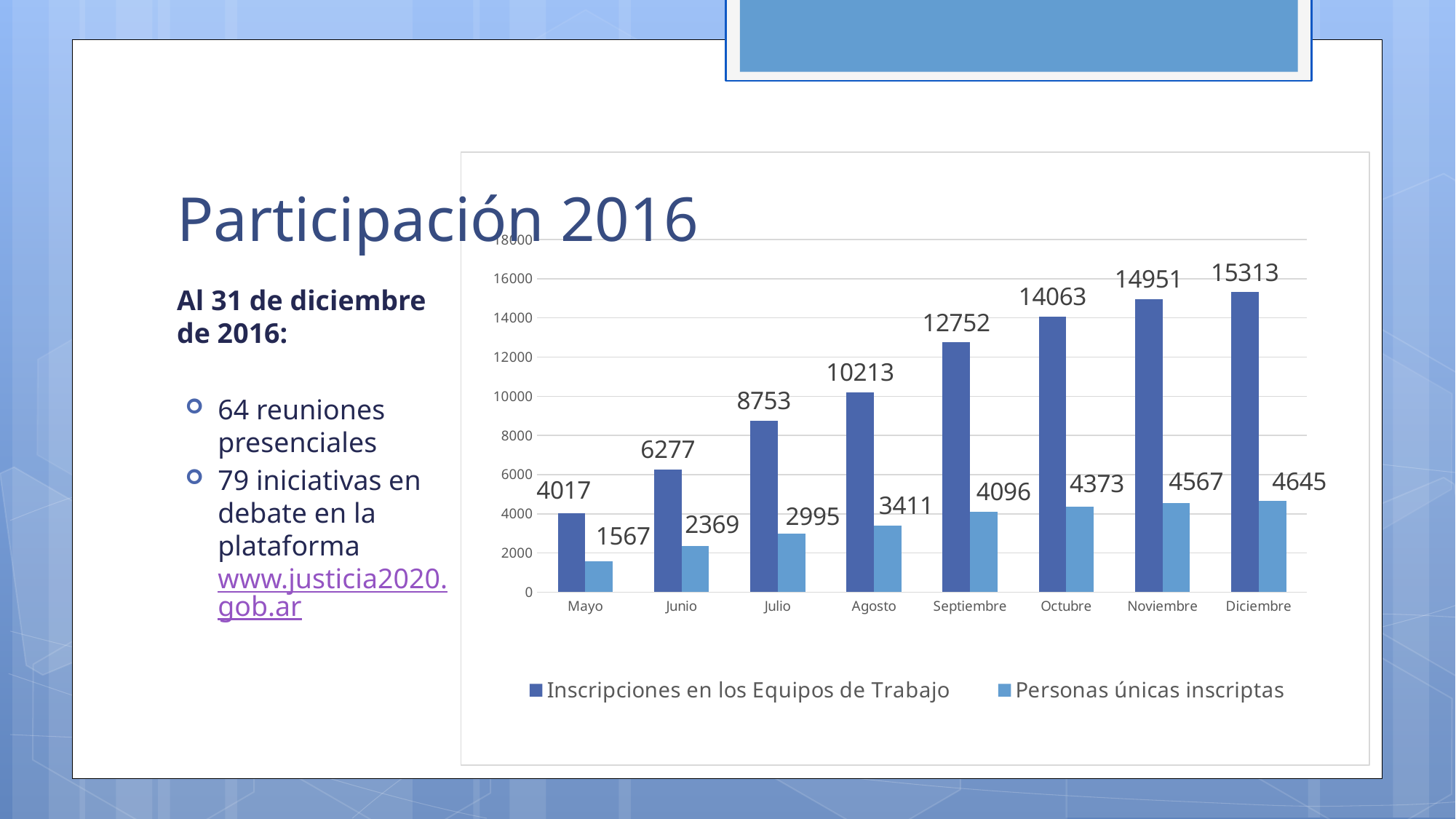
Is the value of Inscripciones en los Equipos de Trabajo for Noviembre greater or less than 14000? greater Which month has the highest value for Inscripciones en los Equipos de Trabajo? Diciembre What is the difference between Inscripciones en los Equipos de Trabajo and Personas únicas inscriptas in Diciembre? 10668 Do the values for Personas únicas inscriptas rise or fall from Mayo to Diciembre? Rise What is the value of Inscripciones en los Equipos de Trabajo for Agosto? 10213 Which is larger: Inscripciones en los Equipos de Trabajo in Julio or Personas únicas inscriptas in Diciembre? Inscripciones en los Equipos de Trabajo in Julio How many months are shown on the x axis of the chart? 8 What is the value of Personas únicas inscriptas for Junio? 2369 By how much did Inscripciones en los Equipos de Trabajo increase from Septiembre to Octubre? 1311 Which month has the lowest value for Personas únicas inscriptas? Mayo What type of chart is shown on the slide? Bar chart How many series does the chart legend list? 2